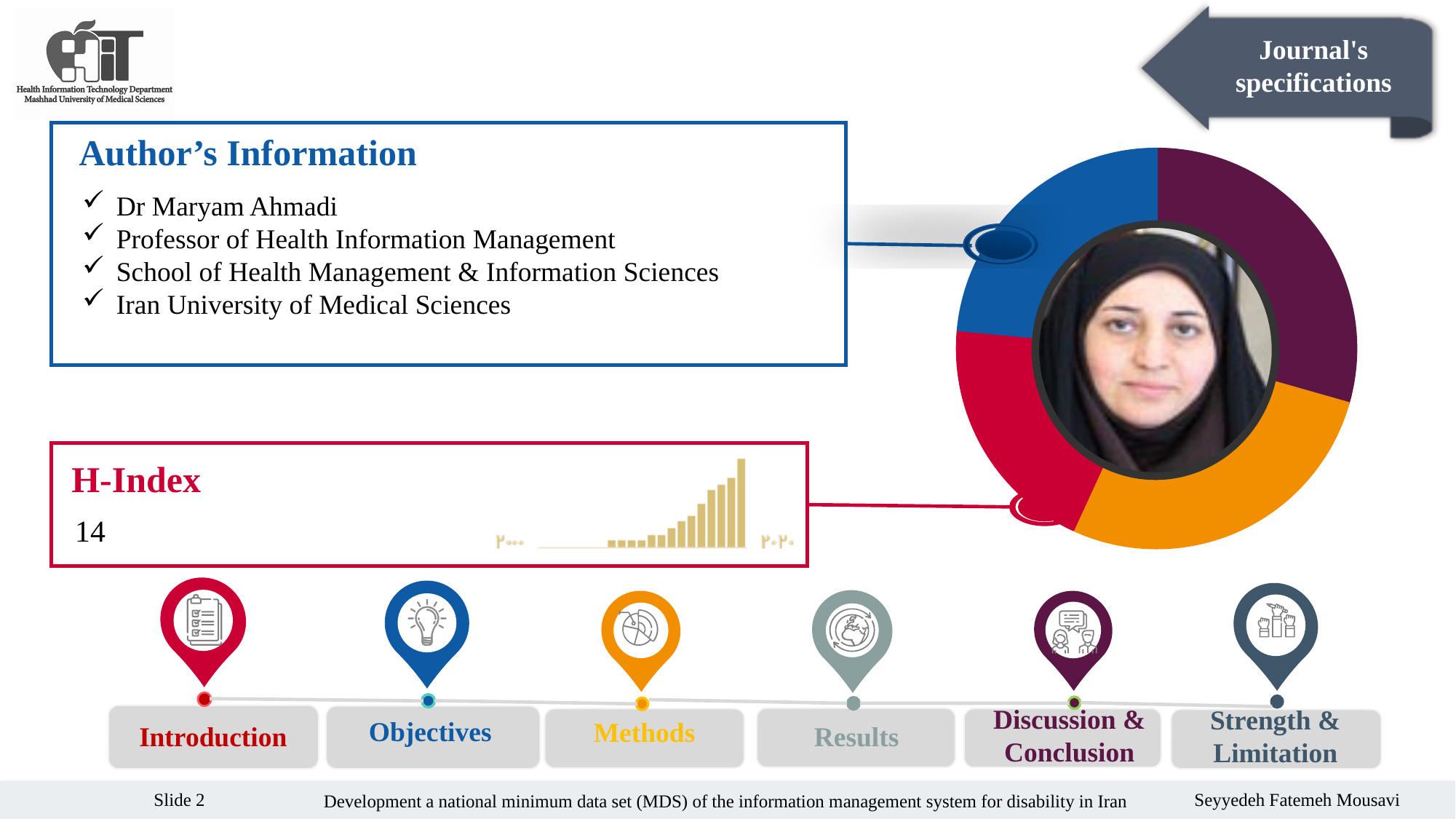
What colour are the bars in the chart in the H-Index box? gold In the bar chart in the H-Index box, is the tallest bar at the left end or the right end? right end In the bar chart in the H-Index box, do the bar heights rise or fall from left to right? rise What is the title of the box that contains the bar chart? H-Index What kind of chart is shown in the H-Index box? bar chart